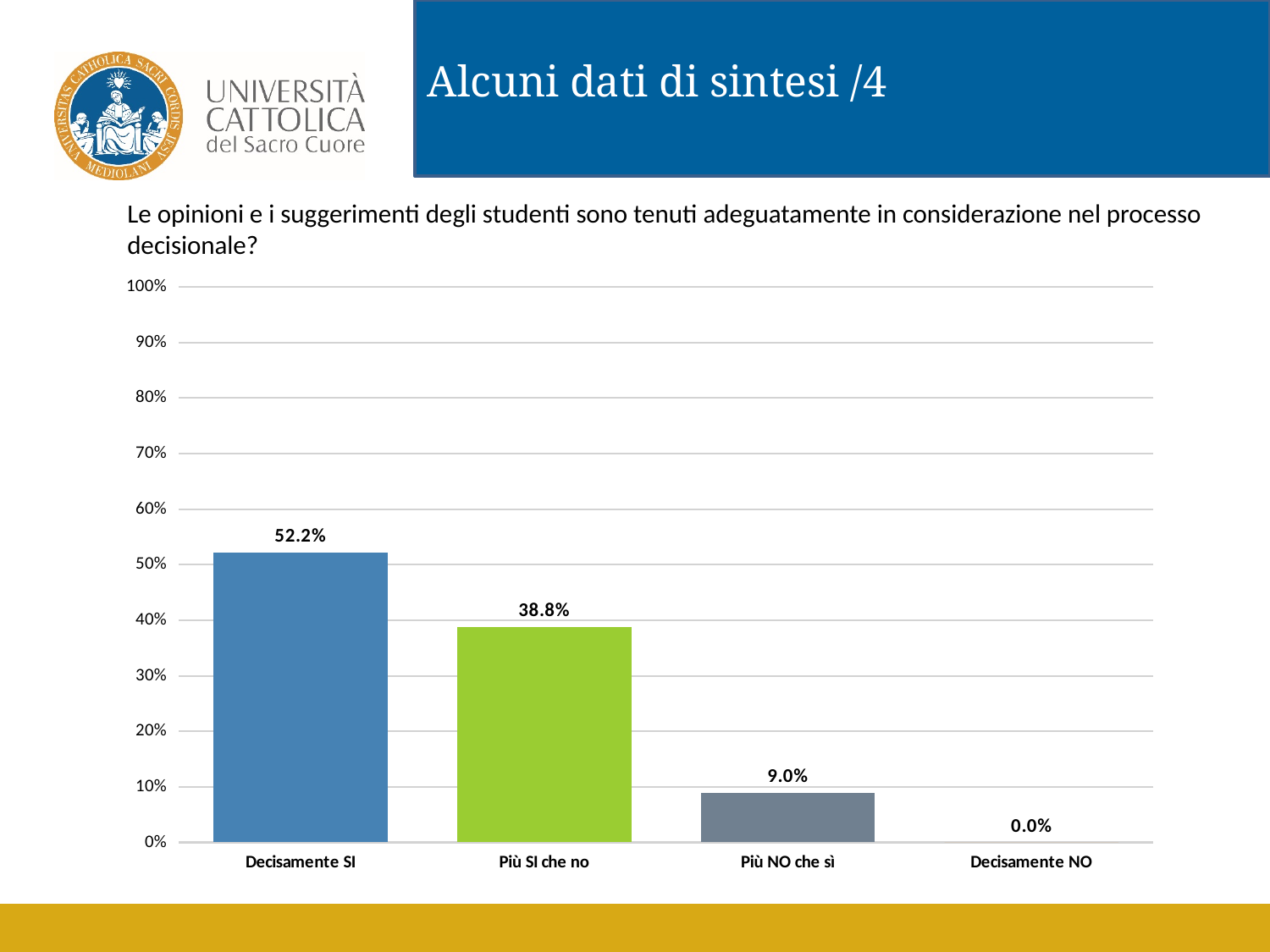
What is the value for "Più NO che sì"? 9.0% What is the value for "Più SI che no"? 38.8% What is the value for "Decisamente NO"? 0.0% Do the values rise or fall from left to right along the x axis? fall Is the value for "Decisamente SI" greater or less than 50%? greater Which category has the highest value? Decisamente SI What kind of chart is shown on the slide? bar chart Which category has the lowest value? Decisamente NO How many categories are shown on the x axis? 4 What is the difference between the values for "Decisamente SI" and "Più SI che no"? 13.4% Which is larger, the value for "Più SI che no" or the value for "Più NO che sì"? Più SI che no What is the value for "Decisamente SI"? 52.2%